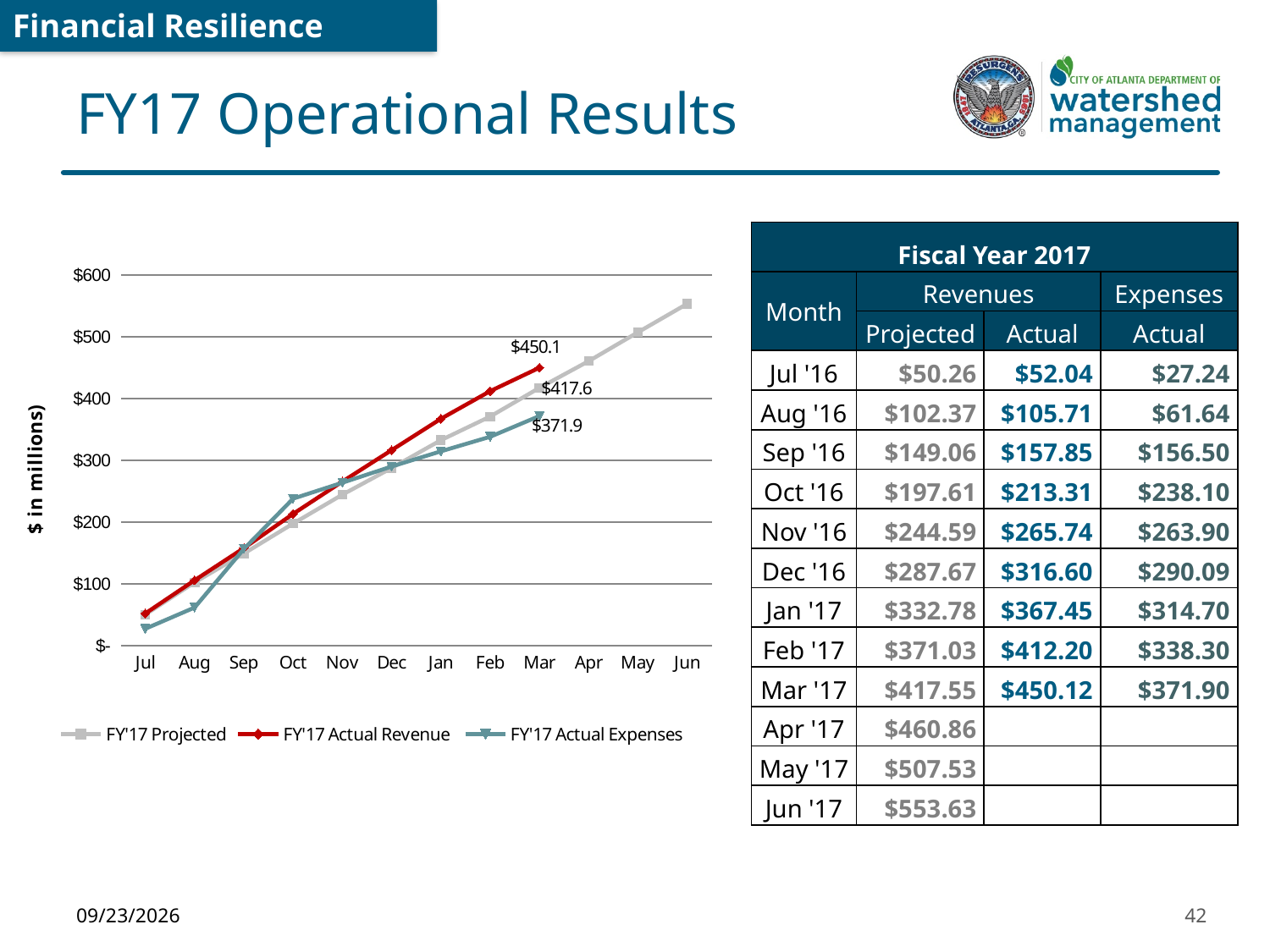
What type of chart is shown on the slide? Line chart By how much does FY'17 Actual Revenue exceed FY'17 Actual Expenses at Mar, using the chart labels? $78.2 How many series does the chart legend list? 3 What is the difference between FY'17 Actual Revenue and FY'17 Projected at Mar, using the chart labels? $32.5 At Mar, which is larger: FY'17 Actual Revenue or FY'17 Actual Expenses? FY'17 Actual Revenue How many months are shown on the x axis of the chart? 12 What is the labelled value of FY'17 Actual Revenue at Mar on the chart? $450.1 What is the labelled value of FY'17 Projected at Mar on the chart? $417.6 Is the FY'17 Projected value at Jun greater or less than $500? greater What is the labelled value of FY'17 Actual Expenses at Mar on the chart? $371.9 Is the FY'17 Actual Expenses value at Oct greater or less than $200? greater Does the FY'17 Projected line rise or fall from Jul to Jun? Rises